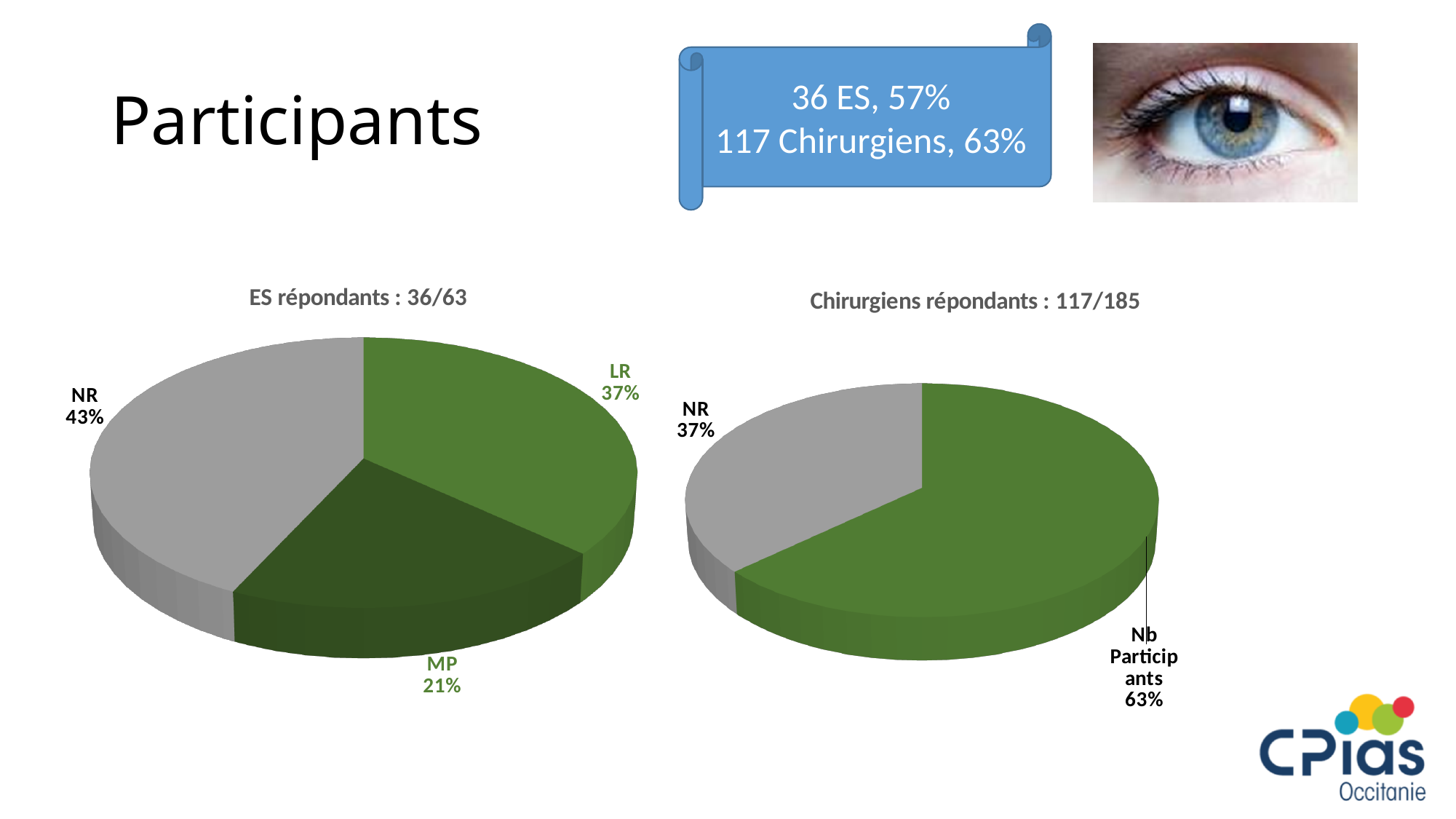
In the 'ES répondants : 36/63' chart, what is the difference between the LR and MP shares? 16% In the 'Chirurgiens répondants : 117/185' chart, which slice is larger, NR or Nb Participants? Nb Participants In the 'ES répondants : 36/63' chart, what share does LR have? 37% In the 'ES répondants : 36/63' chart, which slice is the smallest? MP In the 'ES répondants : 36/63' chart, what share does NR have? 43% In the 'Chirurgiens répondants : 117/185' chart, what share does Nb Participants have? 63% What is the title of the chart on the left of the slide? ES répondants : 36/63 In the 'ES répondants : 36/63' chart, which slice is the largest? NR In the 'ES répondants : 36/63' chart, how many slices are there? 3 What kind of chart is the 'Chirurgiens répondants : 117/185' chart? Pie chart